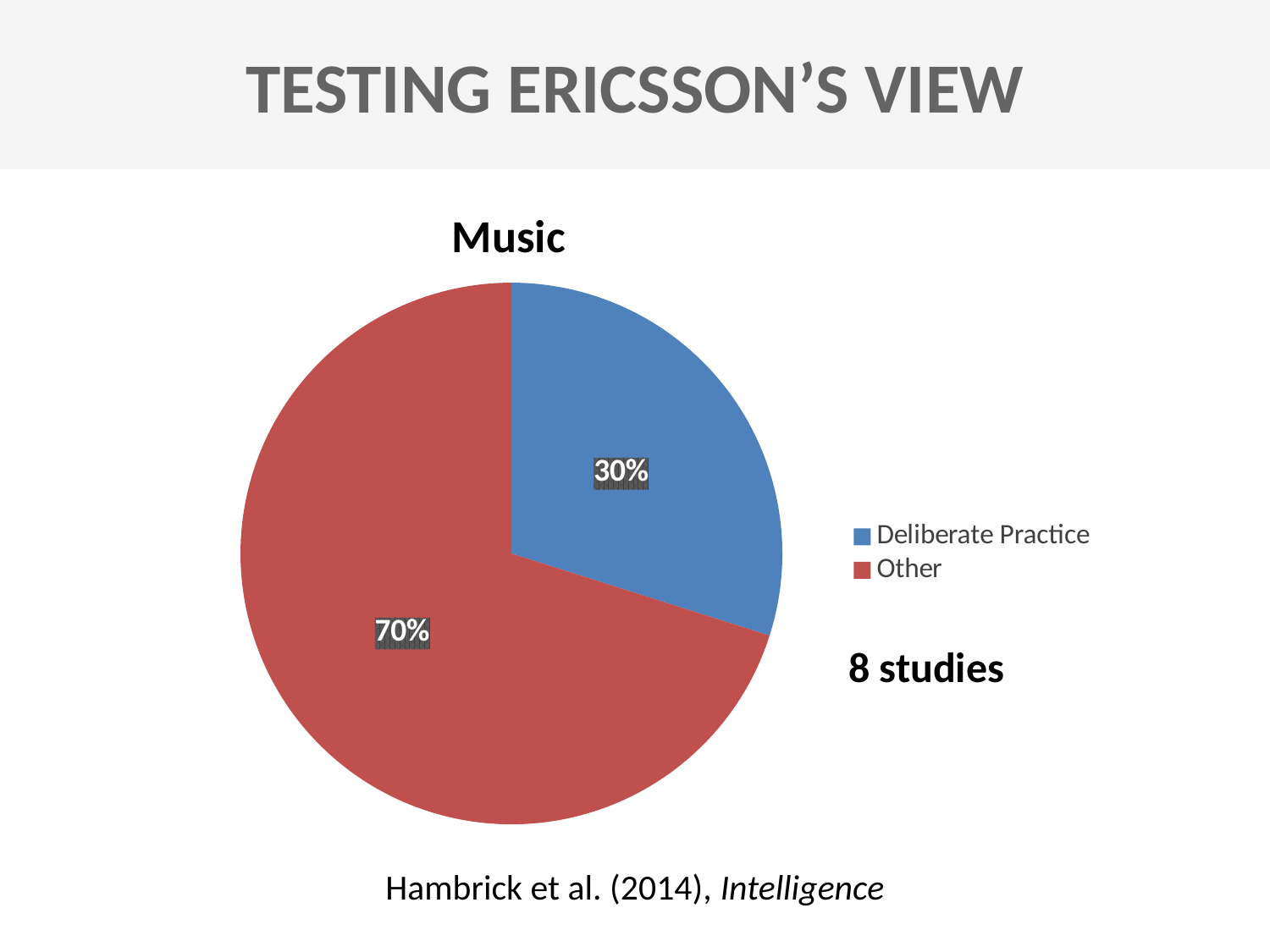
What is the title of the chart? Music Which slice is the largest? Other What is the difference between the Other share and the Deliberate Practice share? 40% Which is larger, the Deliberate Practice slice or the Other slice? Other How many slices does the pie chart have? 2 What colour is the Deliberate Practice slice? blue What share of the pie does Deliberate Practice take? 30% Which slice is the smallest? Deliberate Practice What share of the pie does Other take? 70% Is the share for Deliberate Practice greater or less than 50%? less How many entries does the legend list? 2 What kind of chart is shown on the slide? pie chart